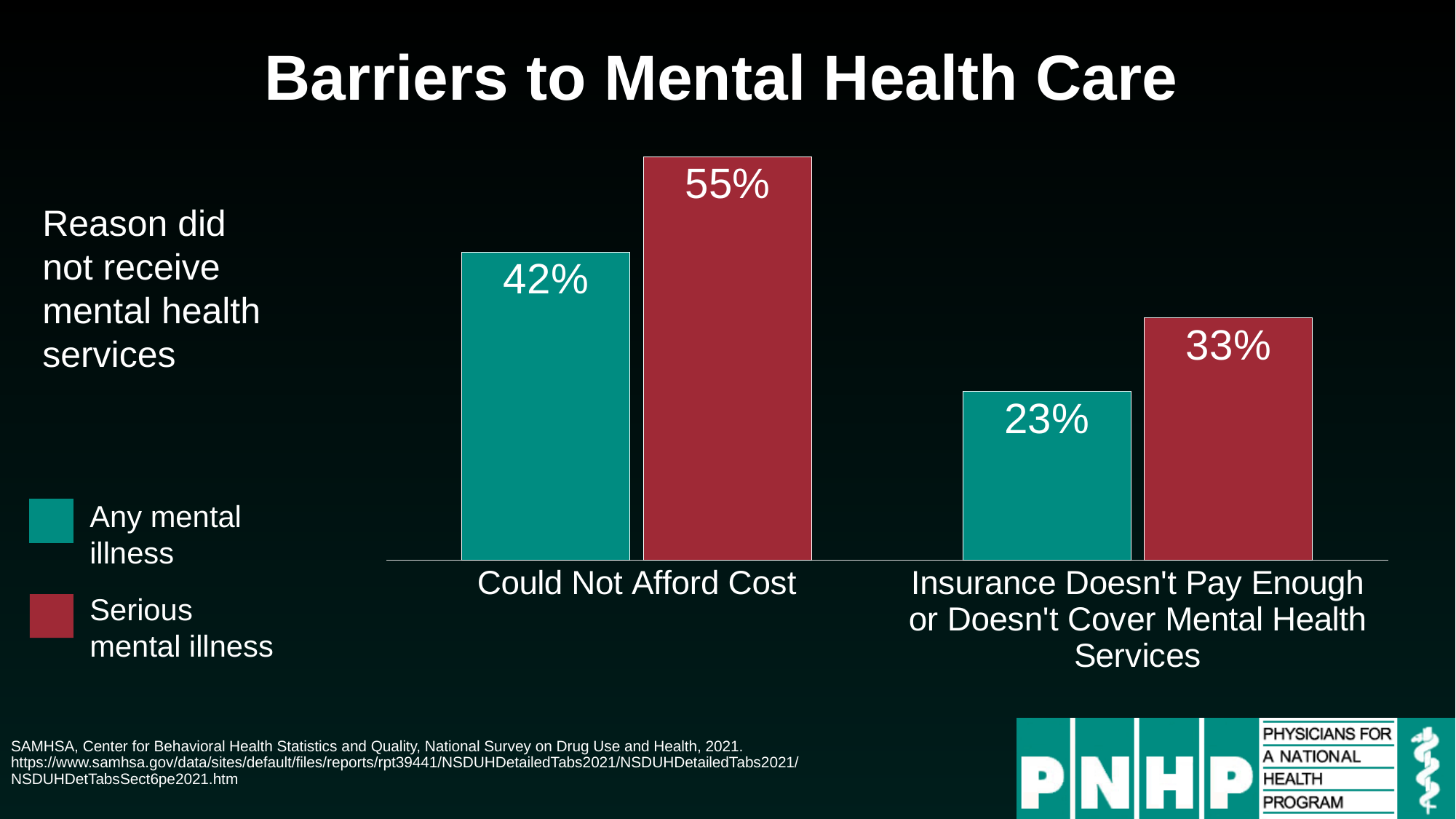
Which bar has the highest value on the chart? Serious mental illness, Could Not Afford Cost What type of chart is shown on the slide? Bar chart What is the value for 'Any mental illness' in the 'Insurance Doesn't Pay Enough or Doesn't Cover Mental Health Services' category? 23% What is the difference between the serious mental illness and any mental illness values for the insurance category? 10% What is the difference between the serious mental illness and any mental illness values for 'Could Not Afford Cost'? 13% What percentage of people with any mental illness cited 'Could Not Afford Cost' as a reason for not receiving mental health services? 42% Which bar has the lowest value on the chart? Any mental illness, Insurance Doesn't Pay Enough or Doesn't Cover Mental Health Services What percentage of people with serious mental illness cited 'Could Not Afford Cost'? 55% How many reason categories are shown on the x axis? 2 What is the value for 'Serious mental illness' in the 'Insurance Doesn't Pay Enough or Doesn't Cover Mental Health Services' category? 33% How many series does the legend list? 2 For 'Could Not Afford Cost', which series has the larger value: any mental illness or serious mental illness? Serious mental illness